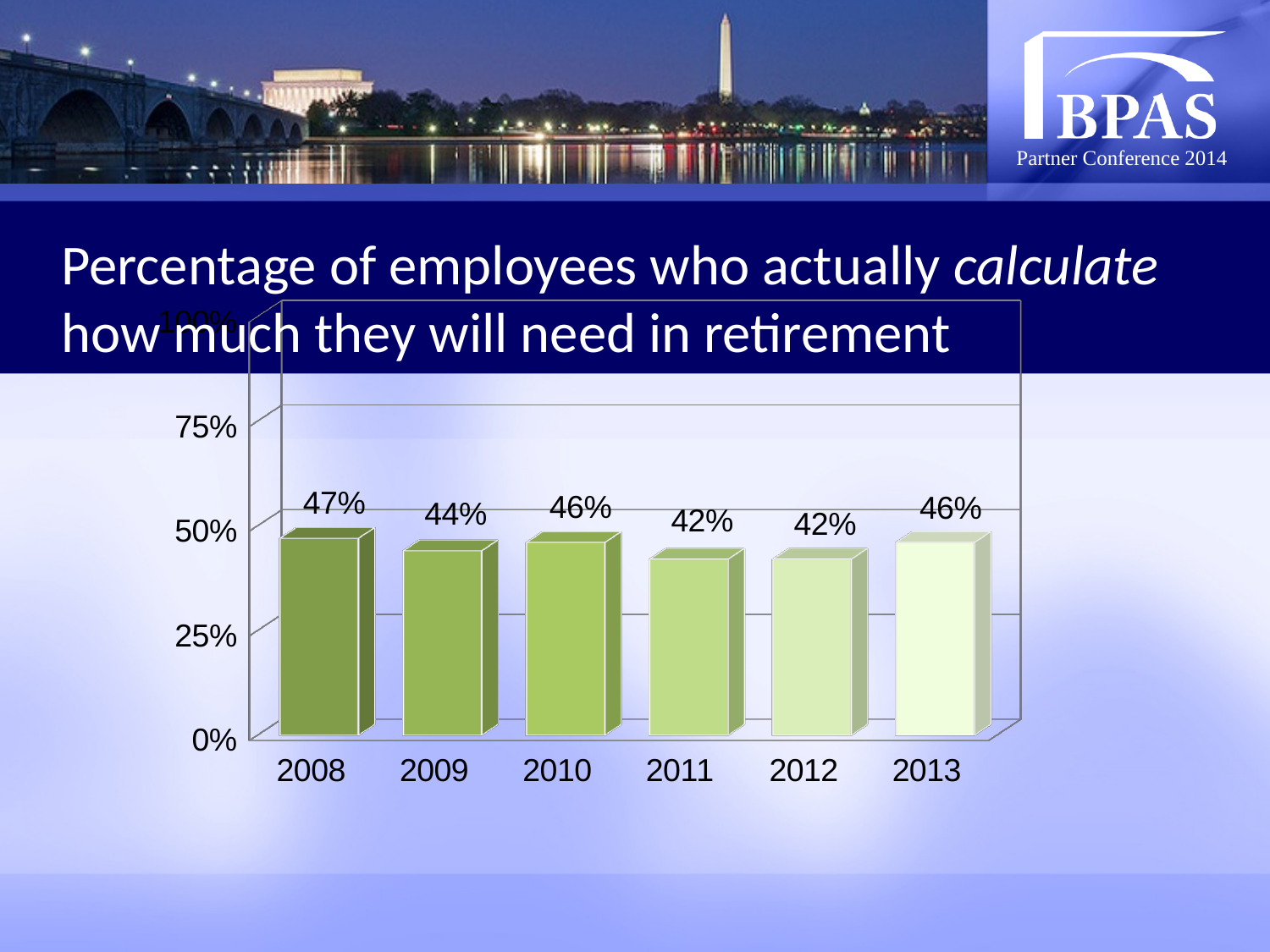
What is the difference between the 2008 value and the 2009 value? 3% What is the value shown for 2013? 46% Which year has the highest percentage? 2008 How many years are shown on the x axis? 6 What is the value shown for 2011? 42% Do the values rise or fall from 2008 to 2009? fall What is the difference between the 2013 value and the 2012 value? 4% Is the value for 2008 greater or less than 50%? less What is the highest value labelled on the y axis? 100% What percentage of employees calculated how much they will need in retirement in 2008? 47% Which is larger, the value for 2010 or the value for 2011? 2010 What kind of chart is shown on the slide? bar chart